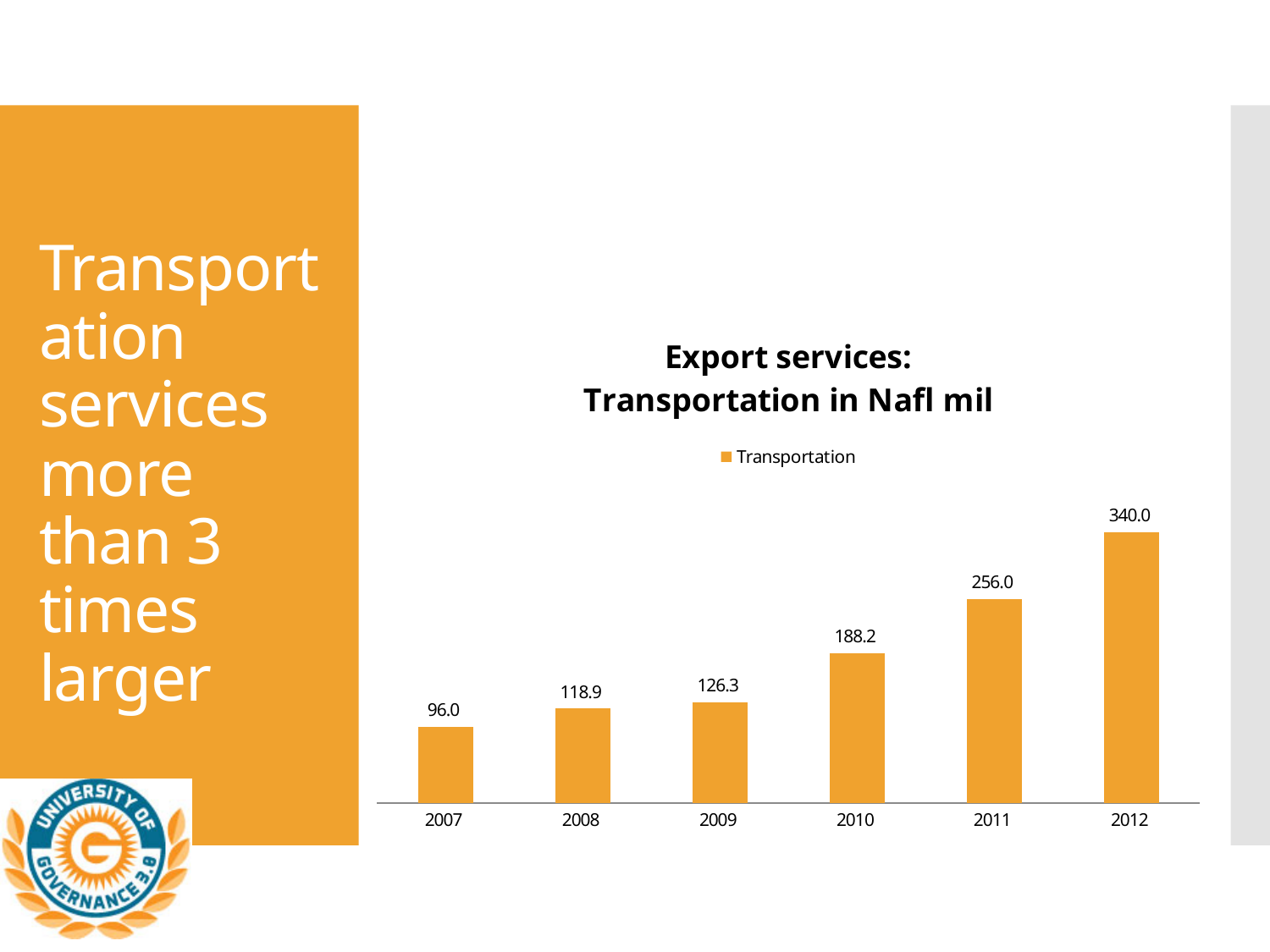
What is the value for 2010? 188.2 What is the value for 2012? 340.0 What is the difference between the values for 2011 and 2010? 67.8 What is the value for 2007? 96.0 Do the values rise or fall from 2007 to 2012? rise How many years are shown on the x axis? 6 Which is larger, the value for 2009 or the value for 2008? 2009 What kind of chart is shown? bar chart Which year has the highest value? 2012 What is the difference between the values for 2012 and 2007? 244.0 How many series does the legend list? 1 Which year has the lowest value? 2007